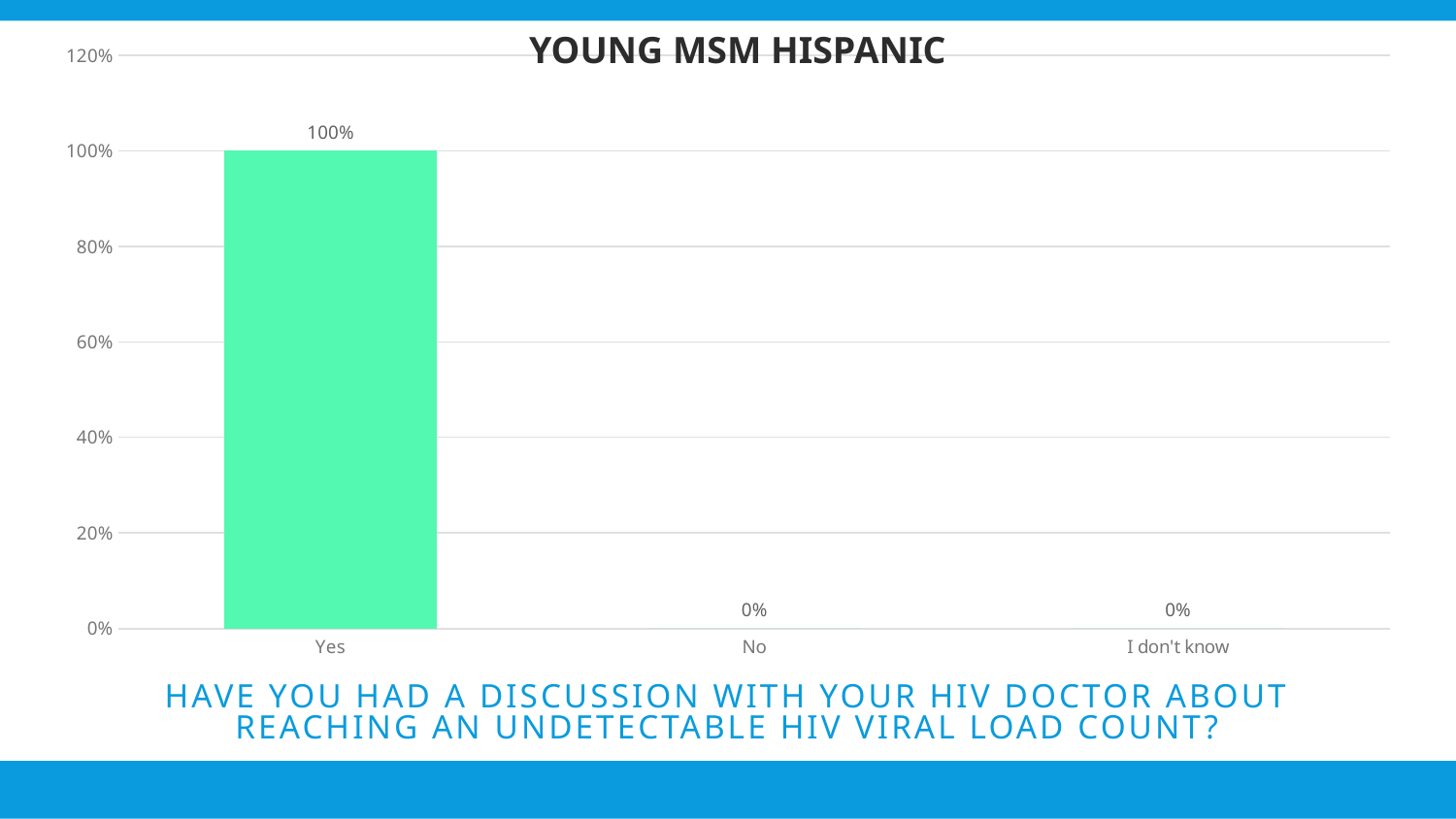
What is the value for Yes? 100% Is the value for Yes greater or less than 80%? greater What kind of chart is shown on the slide? bar chart What is the title of the chart? YOUNG MSM HISPANIC Which is larger, the value for Yes or the value for I don't know? Yes What is the highest value shown on the y axis? 120% What is the difference between the values for Yes and No? 100% What is the value for I don't know? 0% What is the total of the values for Yes, No and I don't know? 100% What is the value for No? 0% Which category has the highest value? Yes How many categories are shown on the x axis? 3